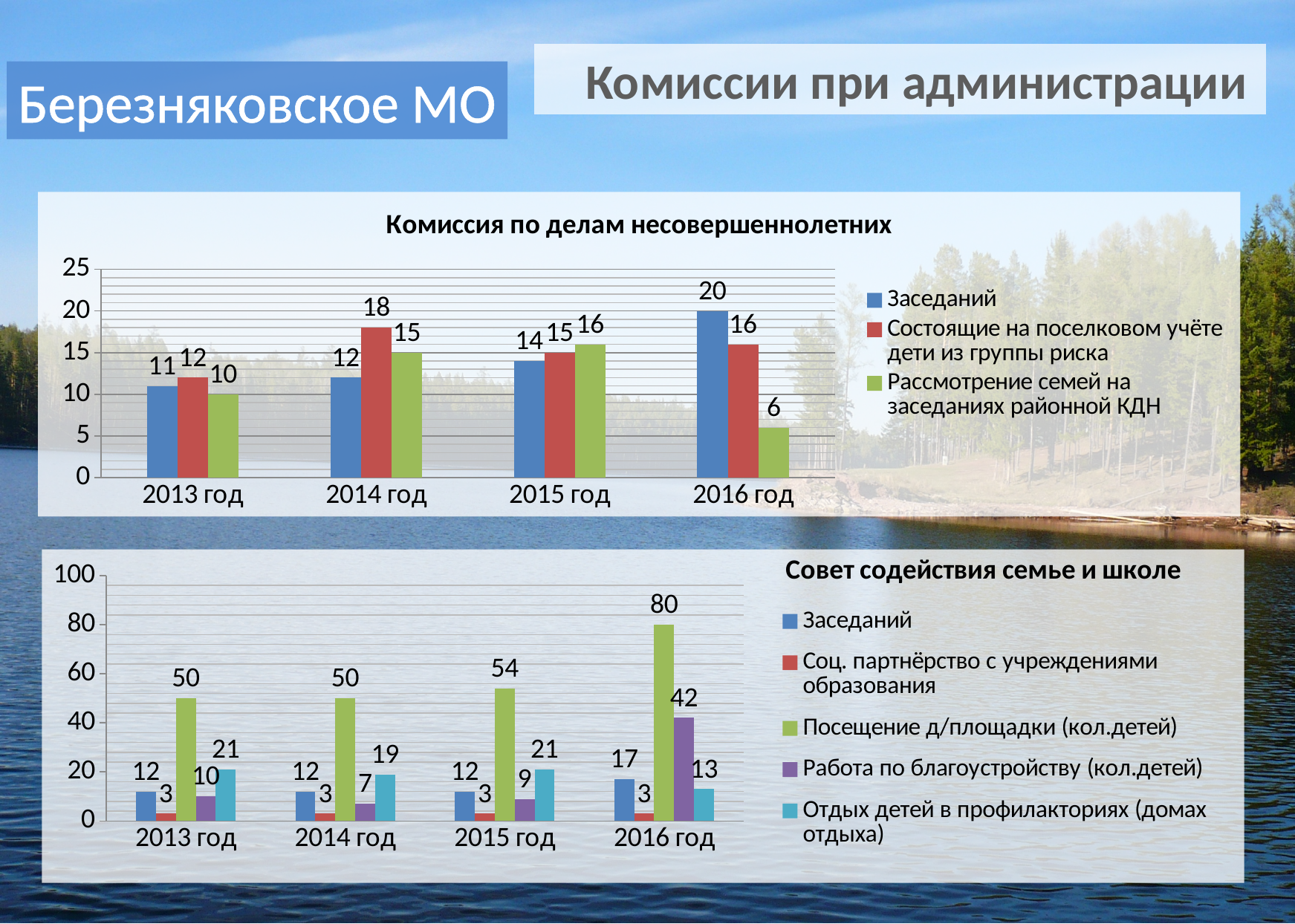
In the chart 'Комиссия по делам несовершеннолетних', in which year is 'Состоящие на поселковом учёте дети из группы риска' highest? 2014 год In the chart 'Комиссия по делам несовершеннолетних', in which year is 'Рассмотрение семей на заседаниях районной КДН' lowest? 2016 год What type of chart is 'Совет содействия семье и школе'? bar chart In the chart 'Комиссия по делам несовершеннолетних', what is the difference between 'Заседаний' in 2016 год and in 2013 год? 9 In the chart 'Комиссия по делам несовершеннолетних', what is the value for 'Рассмотрение семей на заседаниях районной КДН' in 2014 год? 15 In the chart 'Комиссия по делам несовершеннолетних', does the value for 'Заседаний' rise or fall from 2013 год to 2016 год? rise In the chart 'Комиссия по делам несовершеннолетних', what is the value for 'Заседаний' in 2016 год? 20 In the chart 'Совет содействия семье и школе', how many series does the legend list? 5 In the chart 'Комиссия по делам несовершеннолетних', how many series does the legend list? 3 In the chart 'Совет содействия семье и школе', what is the value for 'Работа по благоустройству (кол.детей)' in 2014 год? 7 In the chart 'Совет содействия семье и школе', what is the value for 'Посещение д/площадки (кол.детей)' in 2016 год? 80 In the chart 'Совет содействия семье и школе', which is larger in 2016 год: 'Работа по благоустройству (кол.детей)' or 'Отдых детей в профилакториях (домах отдыха)'? Работа по благоустройству (кол.детей)